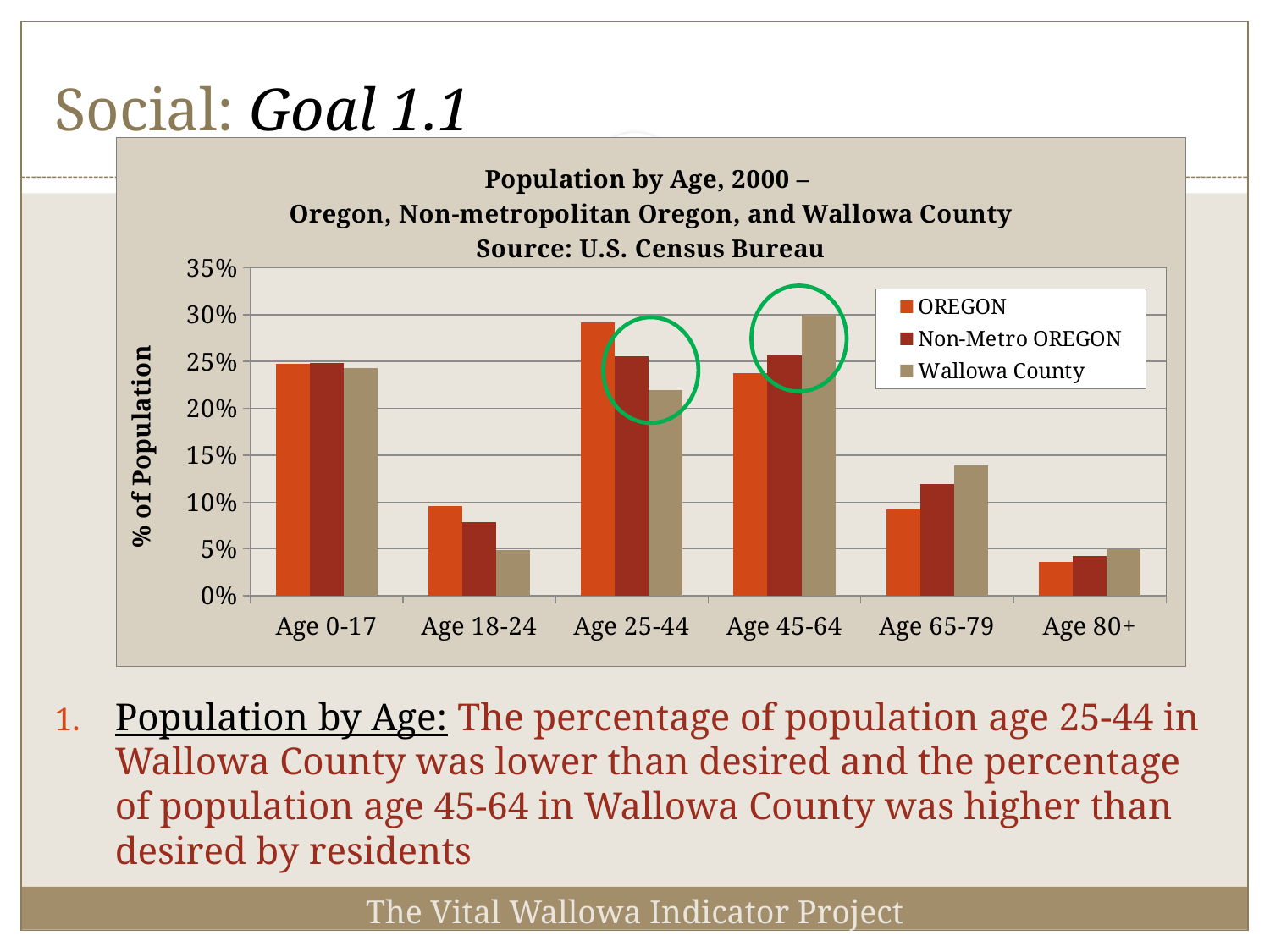
What kind of chart is shown on the slide? Bar chart Which series is shown in the tan/grey colour in the legend? Wallowa County How many series does the legend list? 3 Is the OREGON value for Age 18-24 greater or less than 10%? less Is the Wallowa County value for Age 45-64 greater or less than 25%? greater Is the Wallowa County value for Age 25-44 greater or less than 25%? less For Age 25-44, which is larger: the OREGON value or the Wallowa County value? OREGON How many age categories are shown on the x axis? 6 For Age 45-64, which is larger: the Wallowa County value or the OREGON value? Wallowa County For which age category is the OREGON value lowest? Age 80+ What source is cited in the chart title? U.S. Census Bureau For which age category is the Wallowa County value highest? Age 45-64